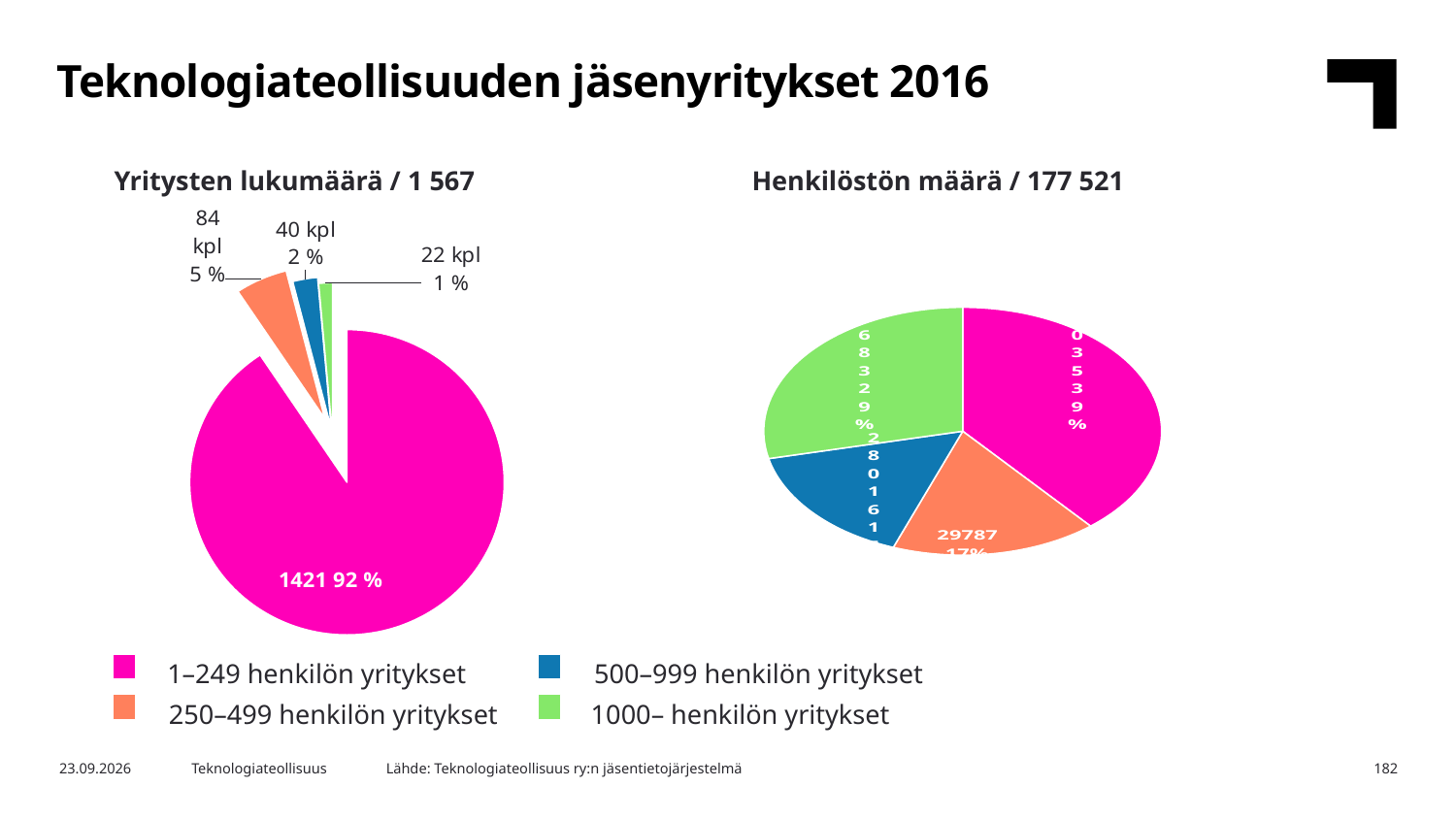
In the left chart "Yritysten lukumäärä / 1 567", what is the value for 1000– henkilön yritykset? 22 kpl In the left chart "Yritysten lukumäärä / 1 567", what is the difference between the values for 250–499 and 500–999 henkilön yritykset? 44 kpl In the left chart "Yritysten lukumäärä / 1 567", what is the value for 500–999 henkilön yritykset? 40 kpl In the right chart "Henkilöstön määrä / 177 521", which category has the largest slice? 1–249 henkilön yritykset In the left chart "Yritysten lukumäärä / 1 567", what is the value for 250–499 henkilön yritykset? 84 kpl In the left chart "Yritysten lukumäärä / 1 567", which is larger: 250–499 henkilön yritykset or 500–999 henkilön yritykset? 250–499 henkilön yritykset How many slices does the left chart "Yritysten lukumäärä / 1 567" have? 4 In the left chart "Yritysten lukumäärä / 1 567", what is the value for 1–249 henkilön yritykset? 1421 In the left chart "Yritysten lukumäärä / 1 567", which category has the smallest slice? 1000– henkilön yritykset In the left chart "Yritysten lukumäärä / 1 567", what share of the pie is 1–249 henkilön yritykset? 92 % What kind of chart is the left chart titled "Yritysten lukumäärä / 1 567"? Pie chart In the right chart "Henkilöstön määrä / 177 521", what is the value for 250–499 henkilön yritykset? 29787